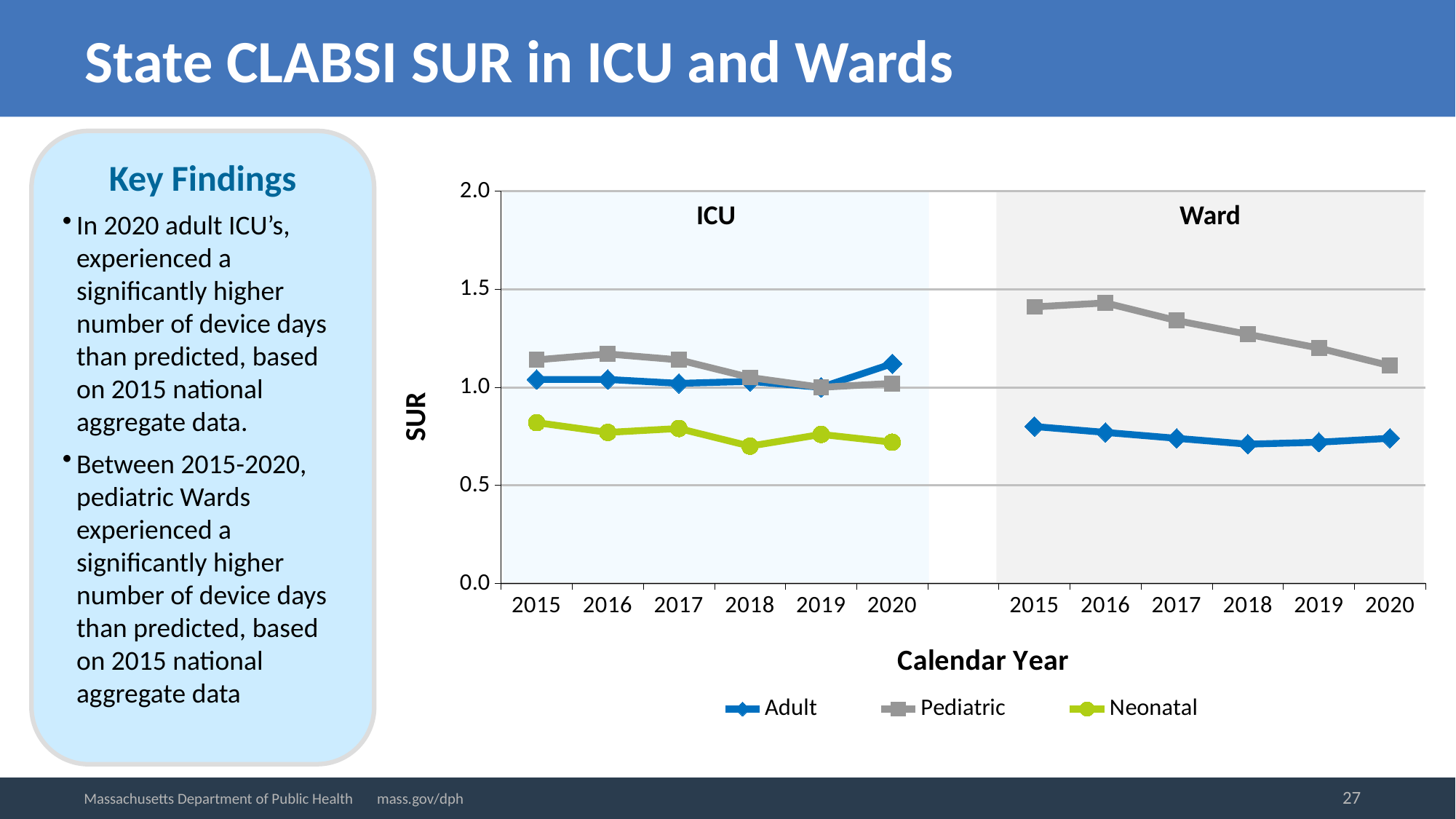
What is the title of the chart's x axis? Calendar Year How many calendar years are plotted in the ICU panel of the chart? 6 In the ICU panel for 2020, which is larger, the Adult value or the Neonatal value? Adult In the Ward panel, is the Pediatric value for 2015 greater or less than 1.0? greater In the Ward panel, does the Pediatric line rise or fall from 2016 to 2020? fall How many series does the chart legend list? 3 In the Ward panel, which year has the lowest Pediatric value? 2020 In the Ward panel, which series has the highest value in 2015? Pediatric What kind of chart is shown on the slide? Line chart For 2016, which is larger, the Pediatric value in the ICU panel or the Pediatric value in the Ward panel? Ward In the Ward panel, is the Adult value for 2018 greater or less than 1.0? less In the ICU panel, is the Neonatal value for 2018 greater or less than 0.5? greater